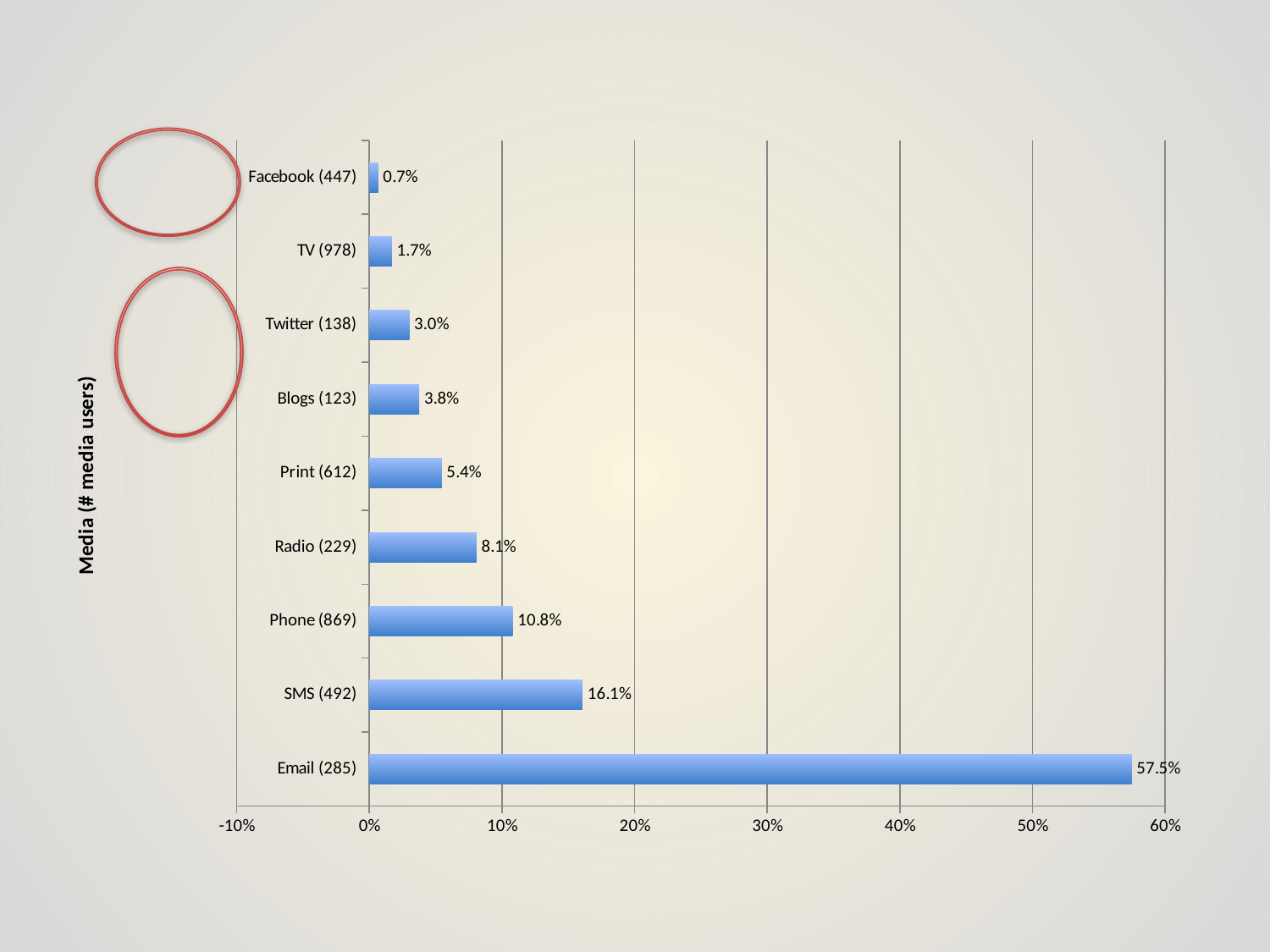
What kind of chart is shown on the slide? bar chart What is the difference between the values for SMS (492) and Phone (869)? 5.3% Which is larger, the value for Radio (229) or the value for Print (612)? Radio (229) Which category has the highest value? Email (285) What is the difference between the values for Blogs (123) and TV (978)? 2.1% Is the value for Email (285) greater or less than 50%? greater What is the value for Twitter (138)? 3.0% What is the value for Phone (869)? 10.8% What is the value for Email (285)? 57.5% What is the label of the vertical axis? Media (# media users) Which category has the lowest value? Facebook (447) How many categories are shown in the chart? 9